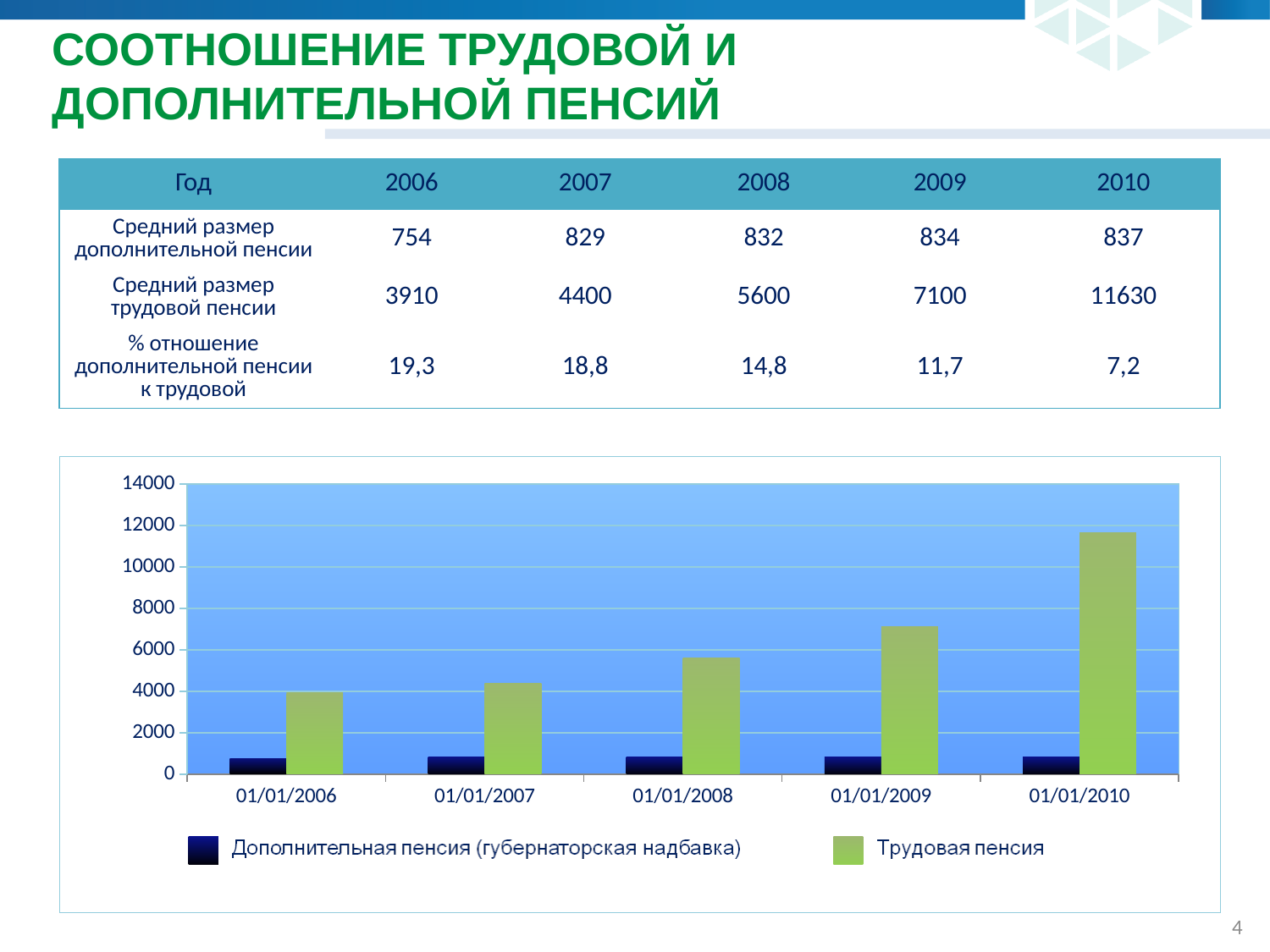
Is the value of Трудовая пенсия for 01/01/2006 greater or less than 6000? less Do the Трудовая пенсия values rise or fall from 01/01/2006 to 01/01/2010? rise How many dates are shown along the x axis of the chart? 5 Is the value of Трудовая пенсия for 01/01/2010 greater or less than 10000? greater Which series is shown in green in the chart? Трудовая пенсия How many series does the chart legend list? 2 At which date is the Трудовая пенсия bar highest? 01/01/2010 According to the table on the slide, what is the average size of the трудовая пенсия in 2010? 11630 What kind of chart is shown on the slide? bar chart At which date is the Трудовая пенсия bar lowest? 01/01/2006 Which is larger at 01/01/2009: Трудовая пенсия or Дополнительная пенсия (губернаторская надбавка)? Трудовая пенсия Is the value of Дополнительная пенсия (губернаторская надбавка) for 01/01/2008 greater or less than 2000? less